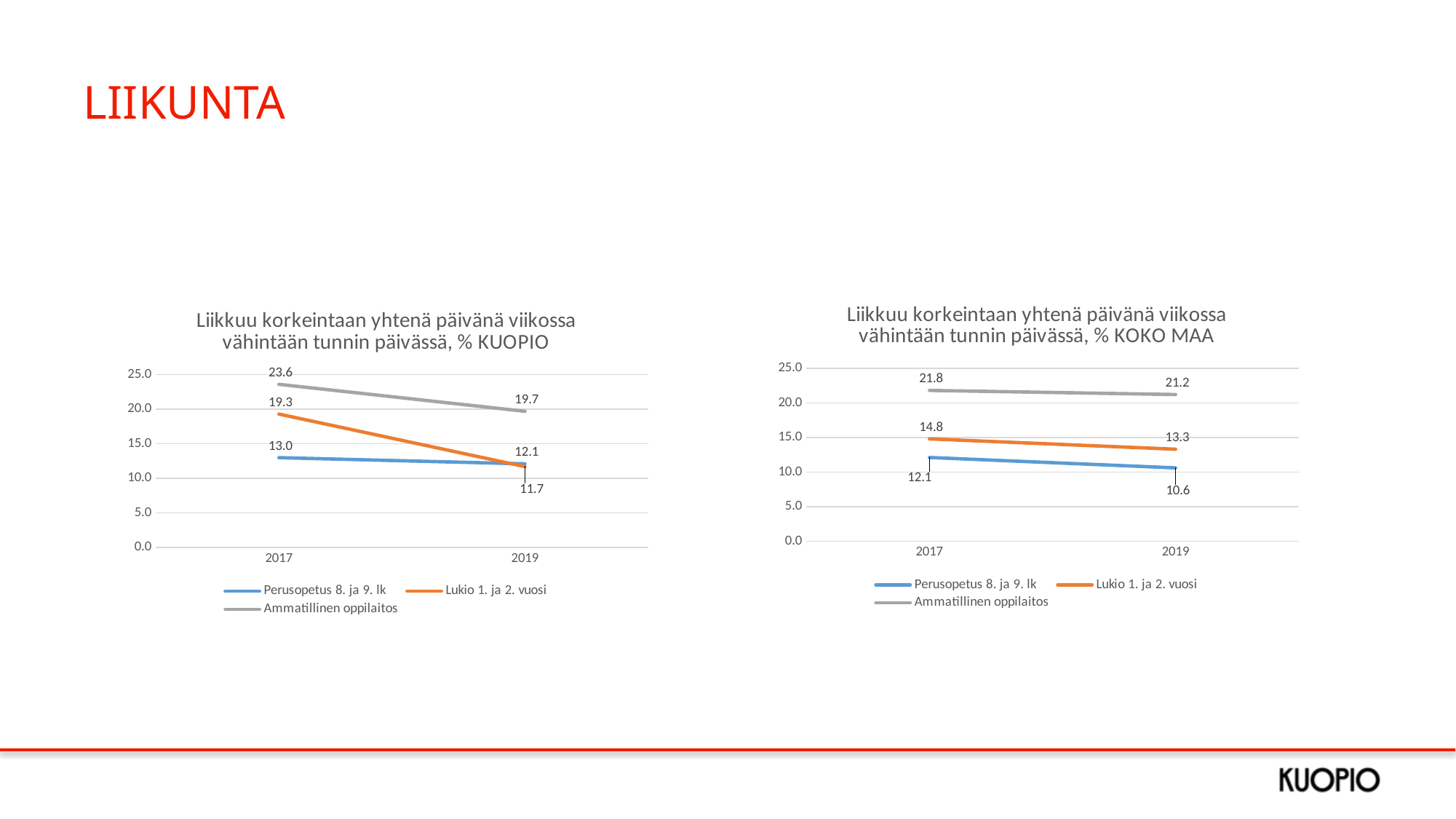
In the KUOPIO chart, what is the value for Lukio 1. ja 2. vuosi in 2019? 11.7 In the KOKO MAA chart, what is the value for Ammatillinen oppilaitos in 2019? 21.2 In the KOKO MAA chart, what is the value for Perusopetus 8. ja 9. lk in 2019? 10.6 In the KUOPIO chart, does the value for Ammatillinen oppilaitos rise or fall from 2017 to 2019? fall In the KUOPIO chart, what is the value for Ammatillinen oppilaitos in 2017? 23.6 What kind of chart is the KUOPIO chart? line chart In the KUOPIO chart, which is larger in 2019: Perusopetus 8. ja 9. lk or Lukio 1. ja 2. vuosi? Perusopetus 8. ja 9. lk In the KUOPIO chart, which series has the highest value in 2017? Ammatillinen oppilaitos In the KOKO MAA chart, which series has the lowest value in 2019? Perusopetus 8. ja 9. lk In the KOKO MAA chart, what is the difference between Ammatillinen oppilaitos and Lukio 1. ja 2. vuosi in 2017? 7.0 How many series does the legend of the KOKO MAA chart list? 3 In the KUOPIO chart, by how much did the value for Lukio 1. ja 2. vuosi fall from 2017 to 2019? 7.6